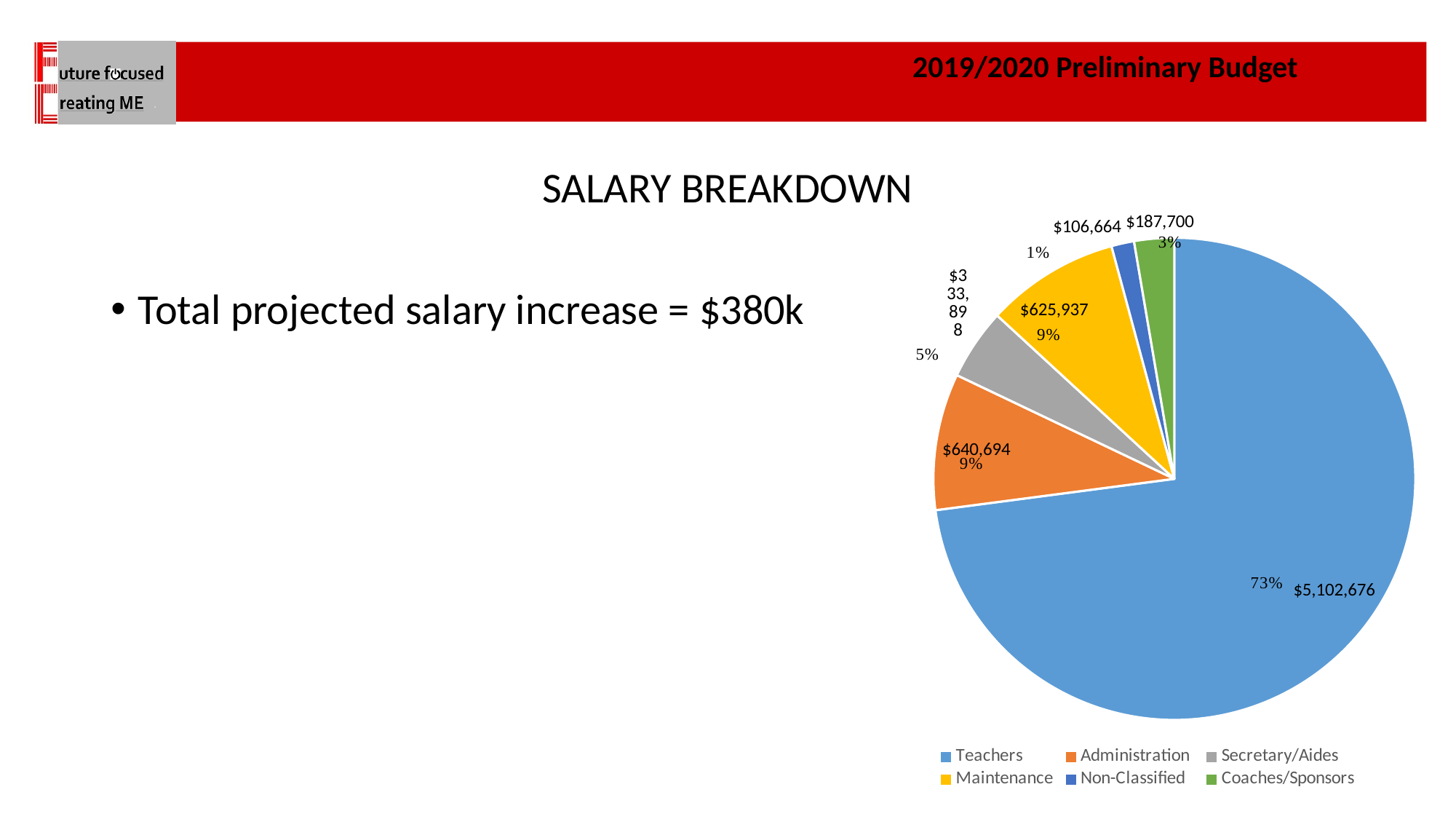
How many categories does the legend list? 6 What is the difference between the Administration and Maintenance salary values? $14,757 What is the salary value for Maintenance? $625,937 Which category has the largest slice of the pie? Teachers What is the salary value for Teachers? $5,102,676 What is the salary value for Administration? $640,694 What kind of chart is shown on the slide? pie chart What share of the pie does Secretary/Aides represent? 5% What is the salary value for Coaches/Sponsors? $187,700 Which category has the smallest slice of the pie? Non-Classified What share of the pie do Teachers represent? 73% What is the salary value for Non-Classified? $106,664